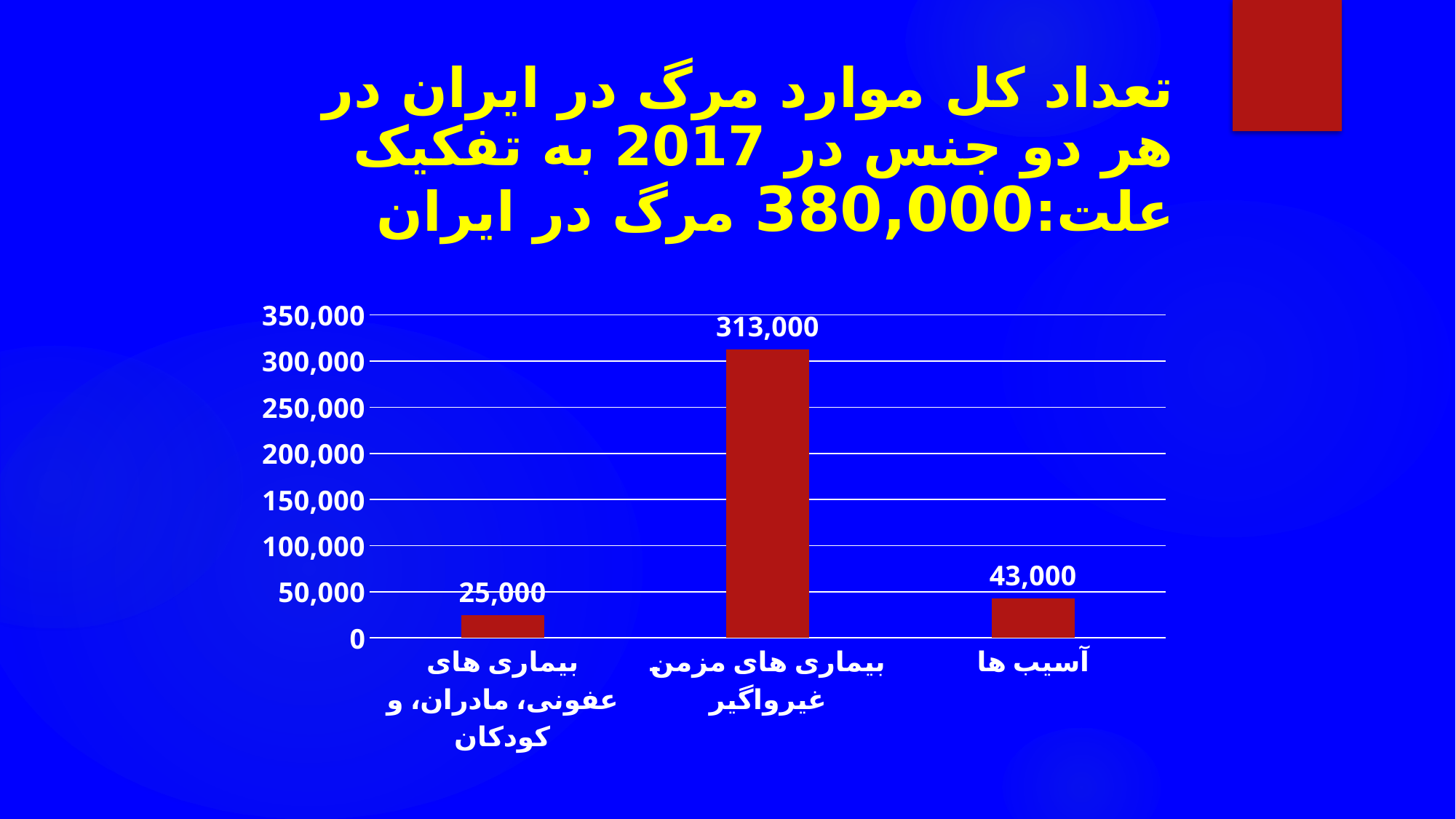
Which is larger, the value for آسیب ها or the value for بیماری های عفونی، مادران، و کودکان? آسیب ها What is the difference between the values for بیماری های مزمن غیرواگیر and آسیب ها? 270,000 Which category has the lowest value? بیماری های عفونی، مادران، و کودکان How many categories are shown in the chart? 3 Which category has the highest value? بیماری های مزمن غیرواگیر What is the value for آسیب ها (injuries)? 43,000 What is the value for بیماری های عفونی، مادران، و کودکان (infectious, maternal and child diseases)? 25,000 What kind of chart is shown on the slide? bar chart What total number of deaths in Iran does the slide title state? 380,000 What is the value for بیماری های مزمن غیرواگیر (chronic non-communicable diseases)? 313,000 Is the value for بیماری های مزمن غیرواگیر greater or less than 300,000? greater What is the difference between the values for آسیب ها and بیماری های عفونی، مادران، و کودکان? 18,000